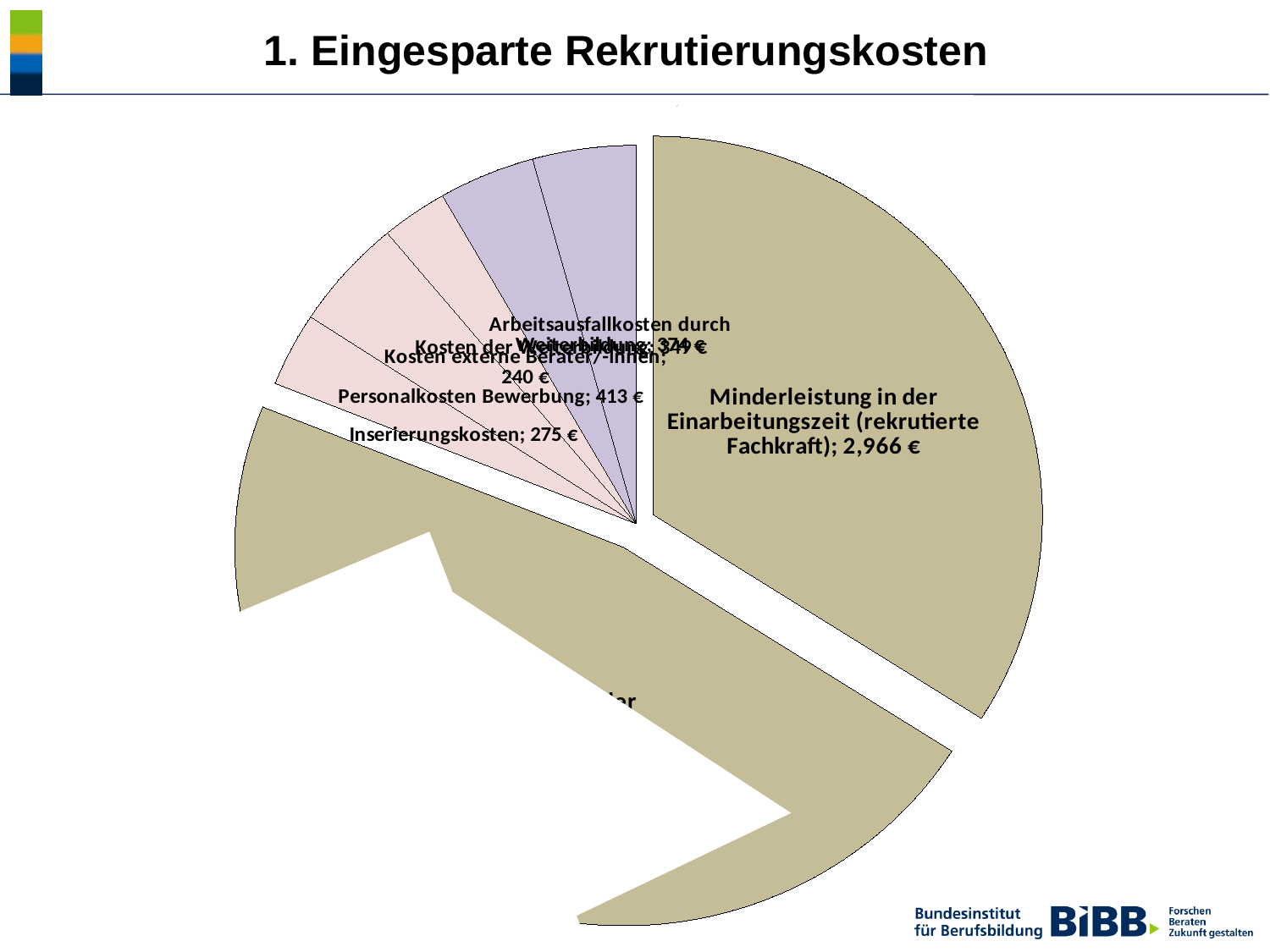
What is the difference between "Personalkosten Bewerbung" and "Kosten externe Berater/-innen"? 173 € What is the value shown for "Minderleistung in der Einarbeitungszeit (rekrutierte Fachkraft)"? 2,966 € What kind of chart is shown on the slide? Pie chart Which is larger, "Inserierungskosten" or "Kosten externe Berater/-innen"? Inserierungskosten What is the title of the slide containing the chart? 1. Eingesparte Rekrutierungskosten What is the difference between "Personalkosten Bewerbung" and "Inserierungskosten"? 138 € What is the value shown for "Kosten externe Berater/-innen"? 240 € Which is larger, "Personalkosten Bewerbung" or "Inserierungskosten"? Personalkosten Bewerbung What is the difference between "Minderleistung in der Einarbeitungszeit (rekrutierte Fachkraft)" and "Inserierungskosten"? 2,691 € What is the value shown for "Personalkosten Bewerbung"? 413 € What is the value shown for "Inserierungskosten"? 275 € In which currency are the values in the chart labelled? €